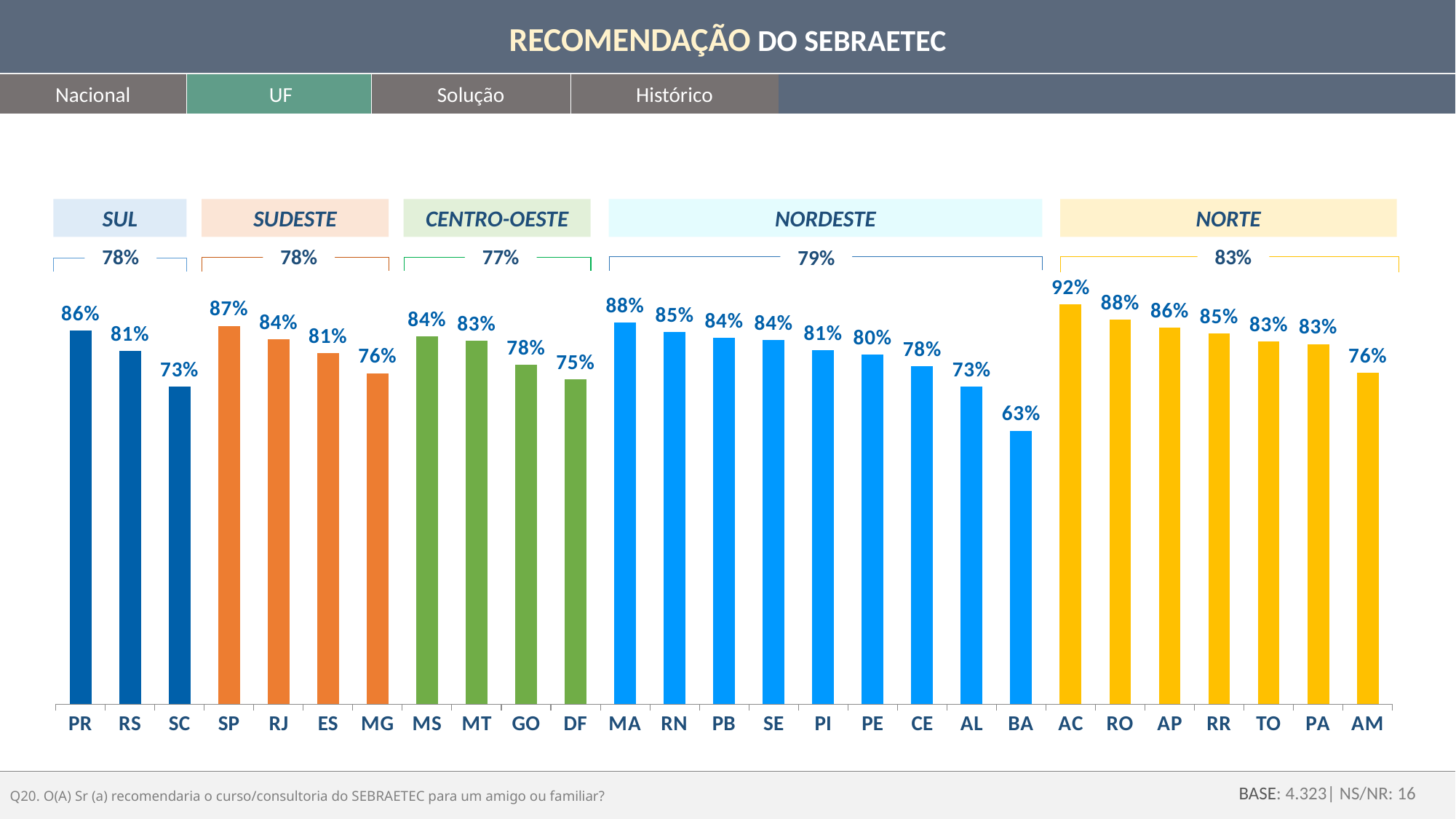
Which has a larger value, MA or RN? MA What is the value shown for BA? 63% Which state has the highest value in the chart? AC What is the value shown for SP? 87% What is the value shown for MT? 83% How many regional groups are labelled above the chart? 5 What is the difference between the values for PR and SC? 13% What kind of chart is shown on the slide? Bar chart How many states are shown on the x axis of the chart? 27 What is the regional value shown for NORTE? 83% What is the difference between the values for AC and AM? 16% Which state has the lowest value in the chart? BA